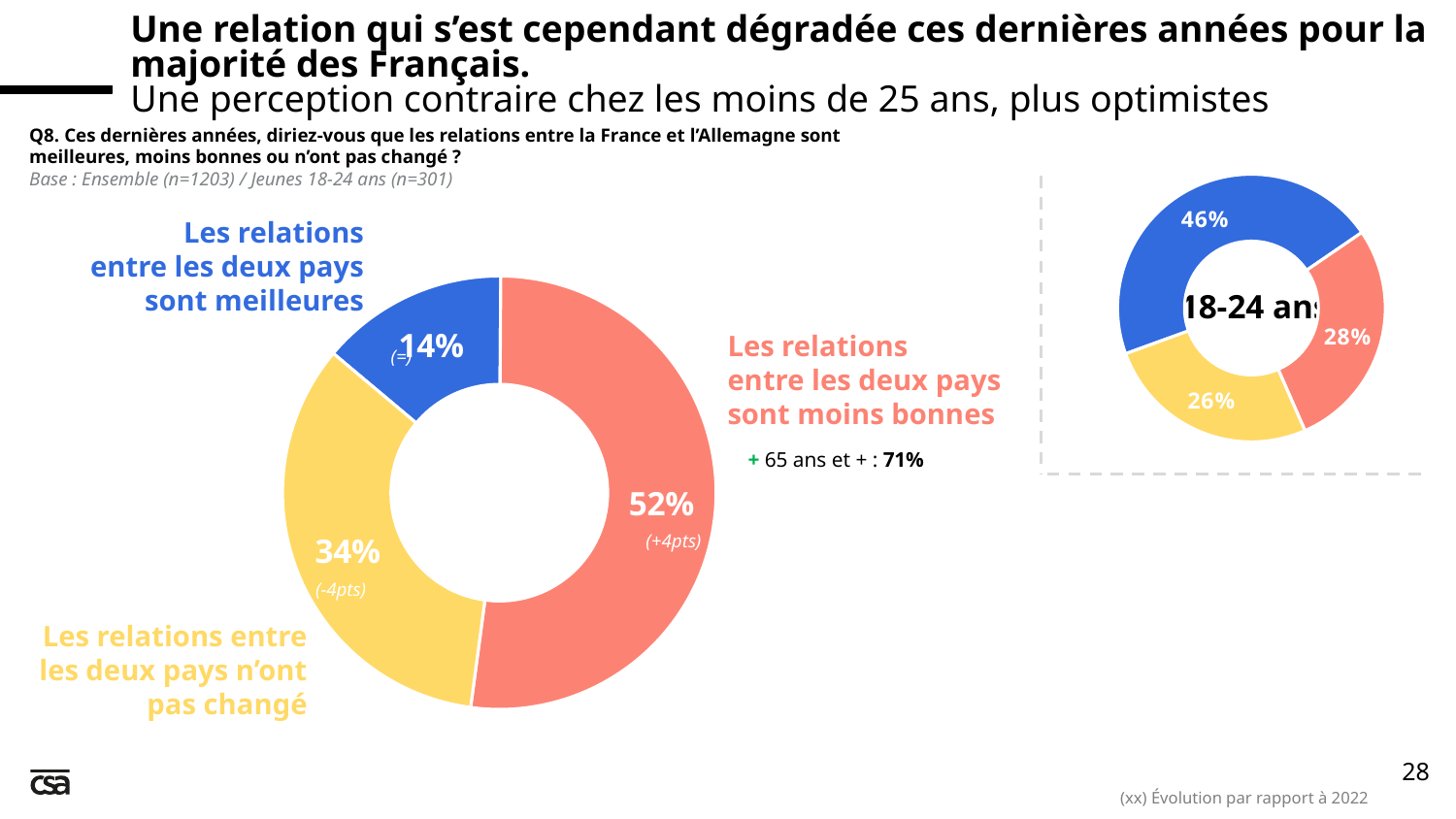
What type of chart is used on this slide? Donut (pie) chart In the large donut chart on the left, what is the difference in percentage points between the "moins bonnes" share and the "n'ont pas changé" share? 18 points How many segments does the large donut chart on the left have? 3 In the large donut chart on the left, what share of respondents say relations between the two countries have not changed? 34% In the large donut chart on the left, what share of respondents say relations between the two countries are better ("meilleures")? 14% In the small "18-24 ans" donut chart on the right, what share of young respondents say relations have not changed (yellow segment)? 26% In the small "18-24 ans" donut chart on the right, which segment is the largest? 46% (relations meilleures, blue) In the large donut chart on the left, what share of respondents say relations between the two countries are worse ("moins bonnes")? 52% In the large donut chart on the left, which response has the largest share? Les relations entre les deux pays sont moins bonnes In the small "18-24 ans" donut chart on the right, what share of young respondents say relations are better (blue segment)? 46% In the small "18-24 ans" donut chart on the right, what share of young respondents say relations are worse (red segment)? 28% In the large donut chart on the left, which response has the smallest share? Les relations entre les deux pays sont meilleures